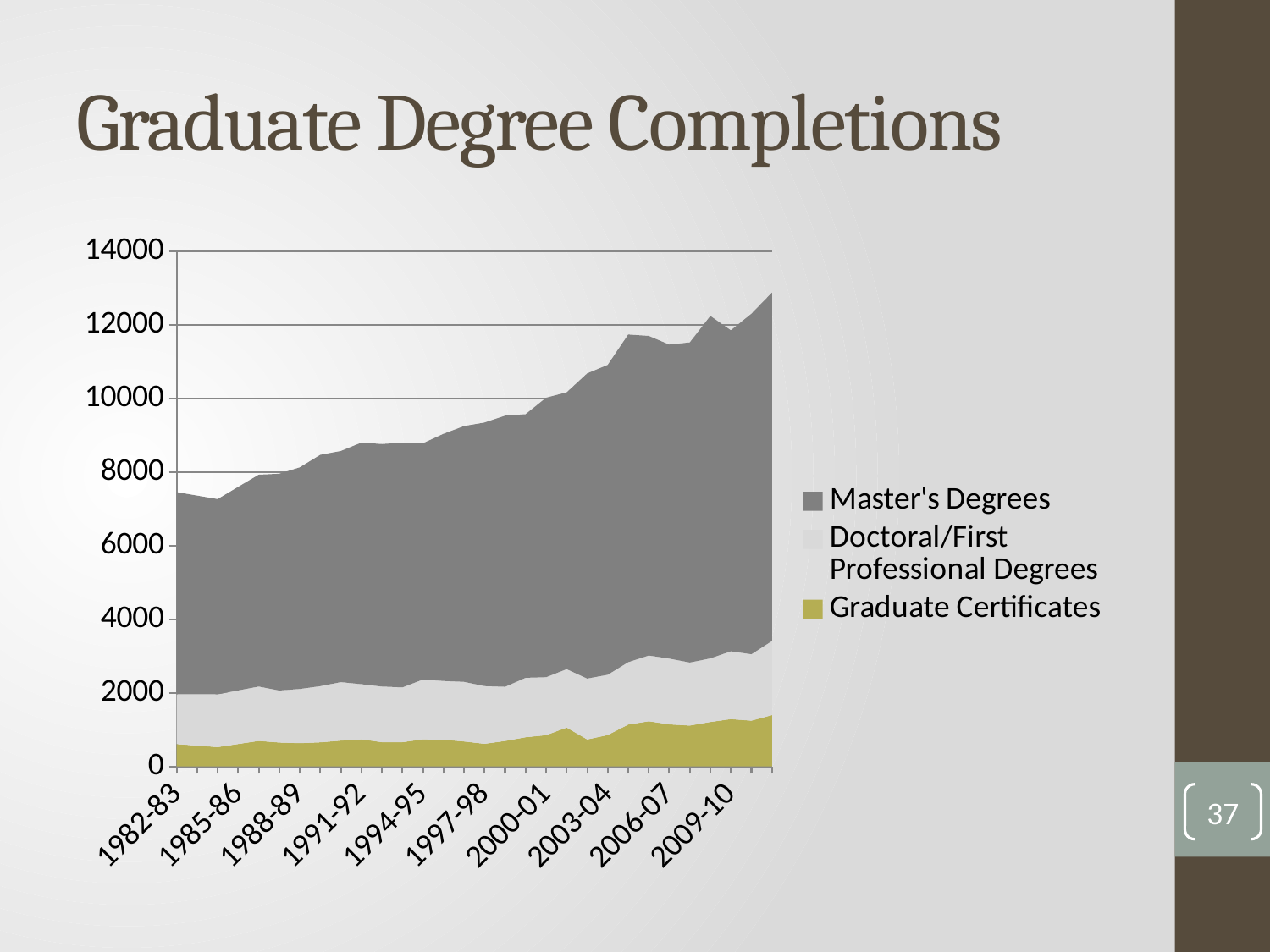
Does the total number of graduate degree completions generally rise or fall from 1982-83 to the end of the period? rise What is the first academic year labelled on the x axis? 1982-83 In 1982-83, which is larger: Doctoral/First Professional Degrees or Graduate Certificates? Doctoral/First Professional Degrees Is the total number of graduate degree completions in 2003-04 greater or less than 10000? greater Which series is shown in the olive/gold colour? Graduate Certificates What kind of chart is shown on the slide? Stacked area chart What is the title of the slide's chart? Graduate Degree Completions Is the value for Graduate Certificates in 1982-83 greater or less than 1000? less Is the total number of graduate degree completions in 1982-83 greater or less than 8000? less Which series accounts for the smallest share of graduate degree completions across the years shown? Graduate Certificates Which series accounts for the largest share of graduate degree completions across the years shown? Master's Degrees How many series does the legend list? 3